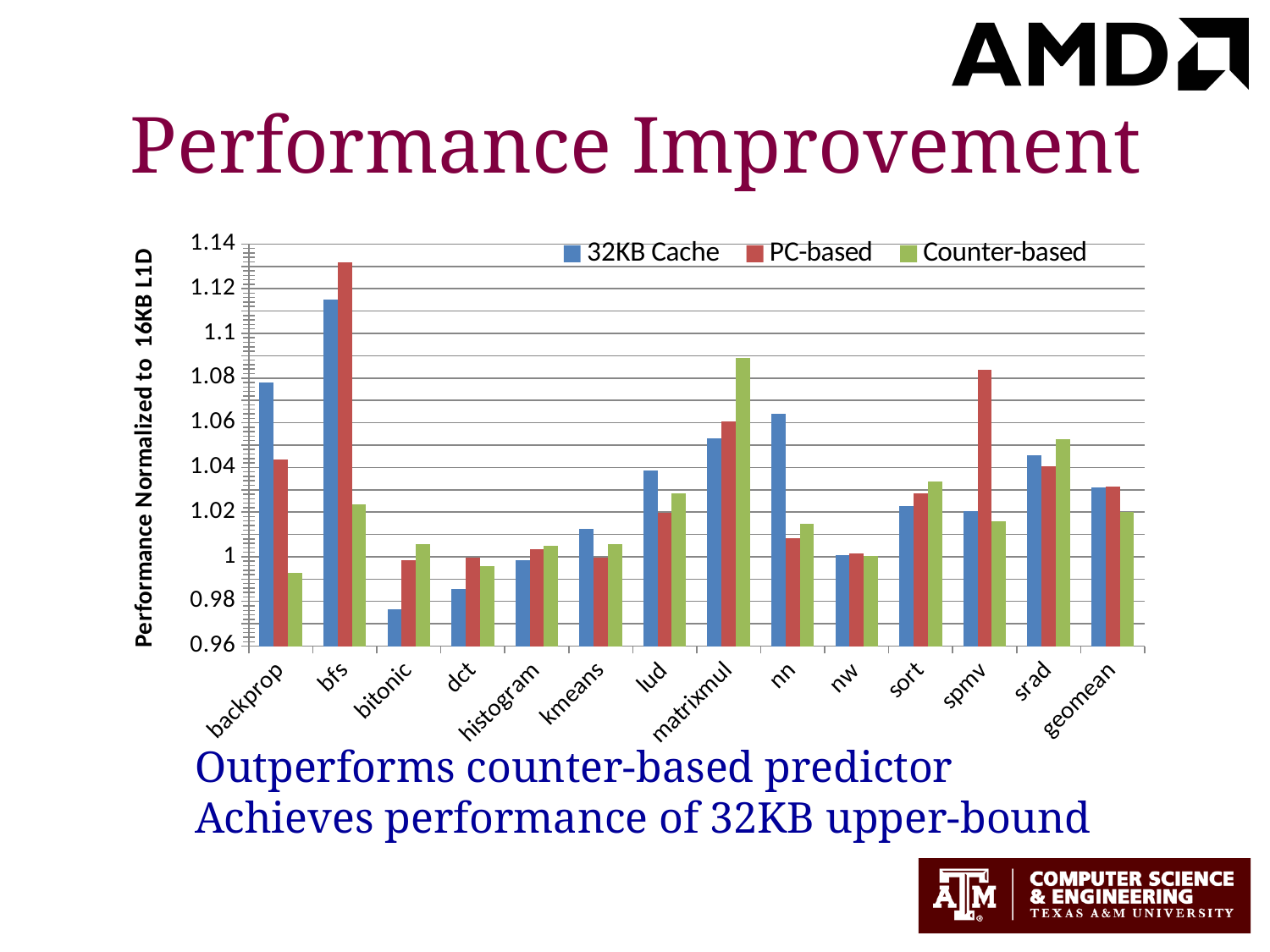
How many series does the legend list? 3 Is the PC-based value for bfs greater or less than 1.12? greater For spmv, which is larger: the PC-based value or the Counter-based value? PC-based Which category has the highest PC-based value? bfs Is the 32KB Cache value for bitonic greater or less than 1? less Is the PC-based value for spmv greater or less than 1.06? greater What is the label of the y axis? Performance Normalized to 16KB L1D What kind of chart is shown on the slide? bar chart How many categories are shown along the x axis? 14 Which category has the highest Counter-based value? matrixmul For nn, which is larger: the 32KB Cache value or the PC-based value? 32KB Cache Which category has the lowest 32KB Cache value? bitonic